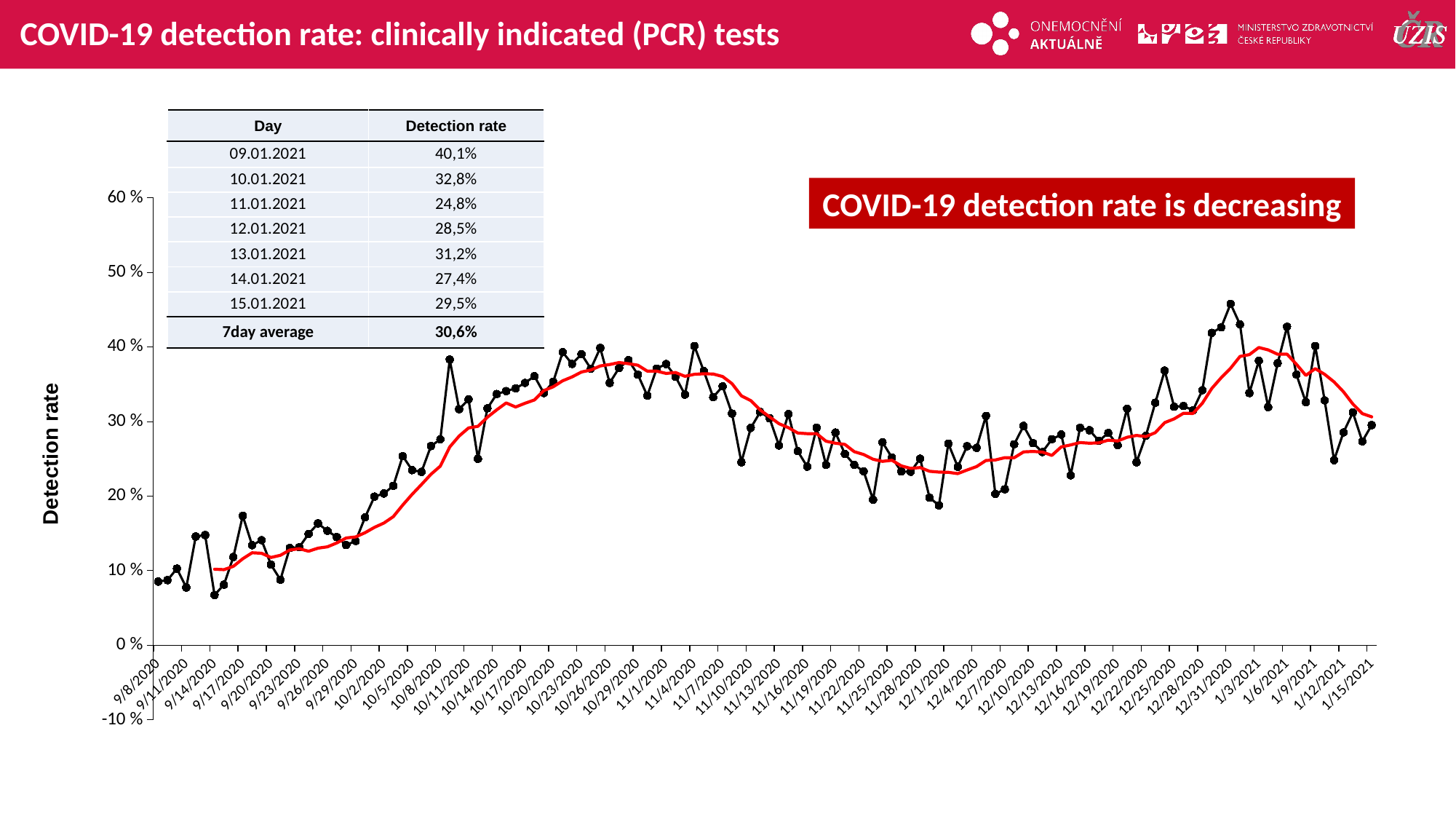
Is the detection rate plotted for 9/8/2020 greater or less than 10 %? less What is the label on the vertical axis of the chart? Detection rate According to the table on the slide, what was the detection rate on 15.01.2021? 29,5% Is the highest daily detection rate plotted near 12/31/2020 greater or less than 40 %? greater Does the detection rate rise or fall between 9/8/2020 and 10/23/2020? rise Of the days listed in the table, which day has the highest detection rate? 09.01.2021 What kind of chart is shown on the slide? line chart Which day in the table has the higher detection rate, 12.01.2021 or 13.01.2021? 13.01.2021 According to the table on the slide, what is the 7day average detection rate? 30,6% Of the days listed in the table, which day has the lowest detection rate? 11.01.2021 According to the table on the slide, what was the detection rate on 09.01.2021? 40,1% By how many percentage points did the detection rate in the table fall from 09.01.2021 to 10.01.2021? 7,3